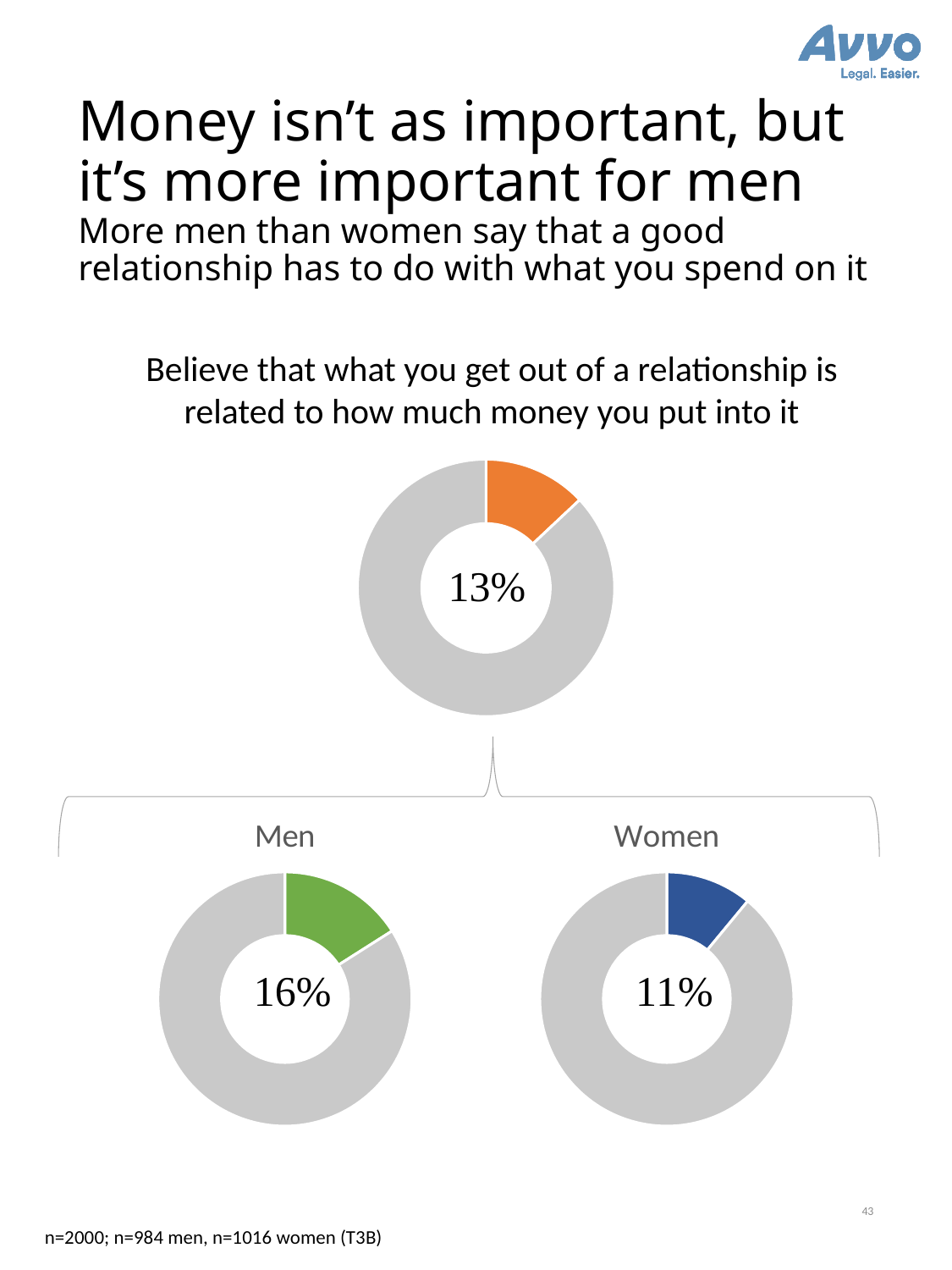
What kind of chart is used to show the 13% value at the top of the slide? Doughnut chart Is the value in the Men doughnut chart greater or less than the value in the overall (top) doughnut chart? greater What is the difference in percentage points between the Men chart value and the Women chart value? 5 percentage points What colour is the highlighted segment in the Men doughnut chart? Green What percentage is shown in the top doughnut chart for all respondents who believe that what you get out of a relationship is related to how much money you put into it? 13% Comparing the Men and Women doughnut charts, which group has the higher percentage? Men Which of the three doughnut charts shows the lowest percentage? Women Is the value in the Women doughnut chart greater or less than the value in the overall (top) doughnut chart? less How many doughnut charts are shown on the slide? 3 In the bottom-right doughnut chart, what percentage of women believe that what you get out of a relationship is related to how much money you put into it? 11% In the bottom-left doughnut chart, what percentage of men believe that what you get out of a relationship is related to how much money you put into it? 16% What colour is the highlighted segment in the Women doughnut chart? Blue